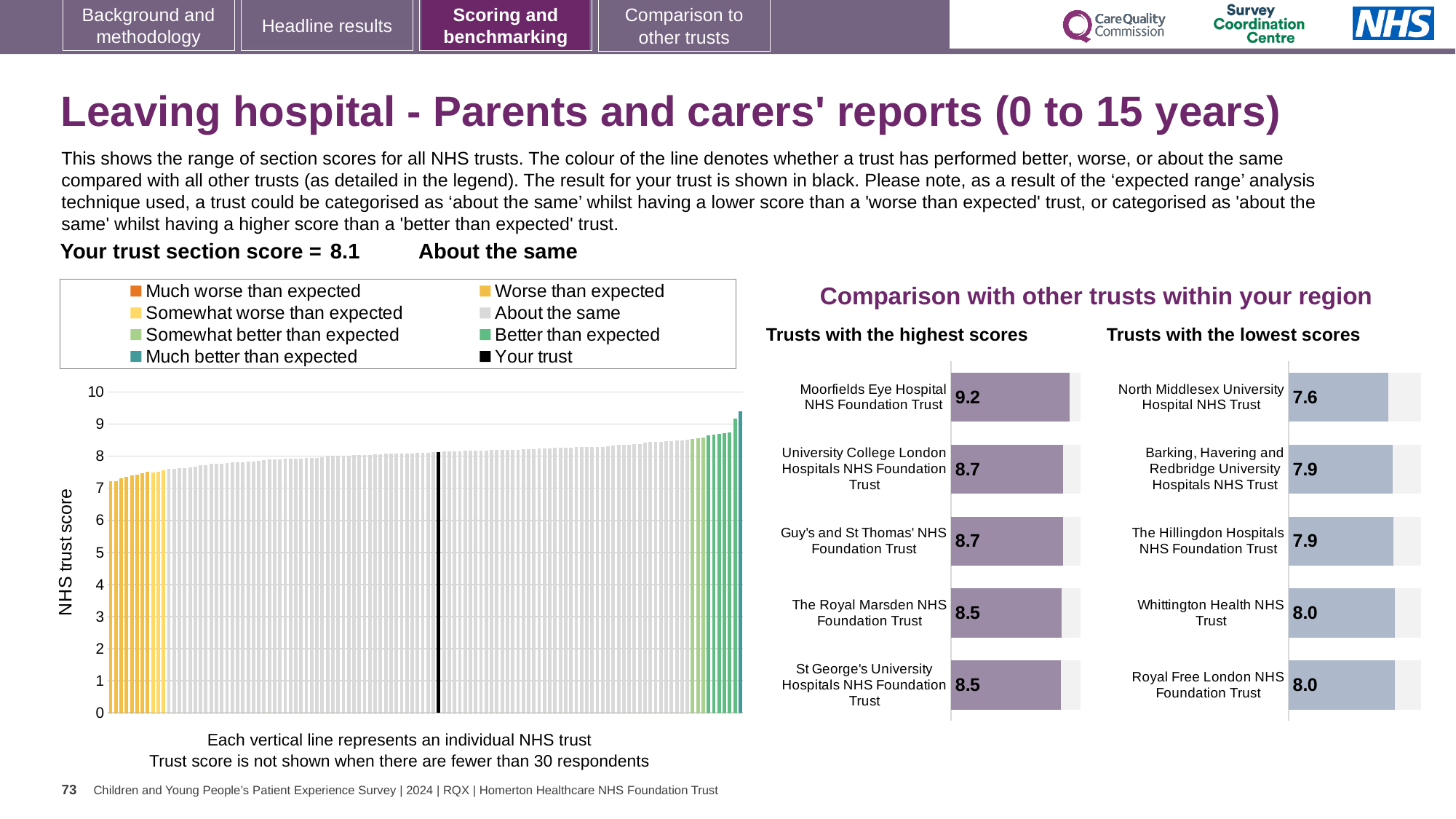
In the 'Trusts with the highest scores' chart, what is the difference between the scores of Moorfields Eye Hospital NHS Foundation Trust and The Royal Marsden NHS Foundation Trust? 0.7 What kind of chart is the main chart on the left showing NHS trust scores? Bar chart In the 'Trusts with the lowest scores' chart, which has the larger score: Whittington Health NHS Trust or North Middlesex University Hospital NHS Trust? Whittington Health NHS Trust In the 'Trusts with the highest scores' chart, what is the score for Moorfields Eye Hospital NHS Foundation Trust? 9.2 In the main chart on the left showing all NHS trusts, what is the section score for your trust (shown in black)? 8.1 In the 'Trusts with the highest scores' chart, which trust has the highest score? Moorfields Eye Hospital NHS Foundation Trust How many trusts are shown in the 'Trusts with the highest scores' chart? 5 In the 'Trusts with the lowest scores' chart, what is the score for The Hillingdon Hospitals NHS Foundation Trust? 7.9 In the main chart on the left, do the trust scores rise or fall from left to right? Rise How many entries does the legend of the main chart on the left list? 8 In the 'Trusts with the lowest scores' chart, which trust has the lowest score? North Middlesex University Hospital NHS Trust In the 'Trusts with the lowest scores' chart, what is the score for North Middlesex University Hospital NHS Trust? 7.6